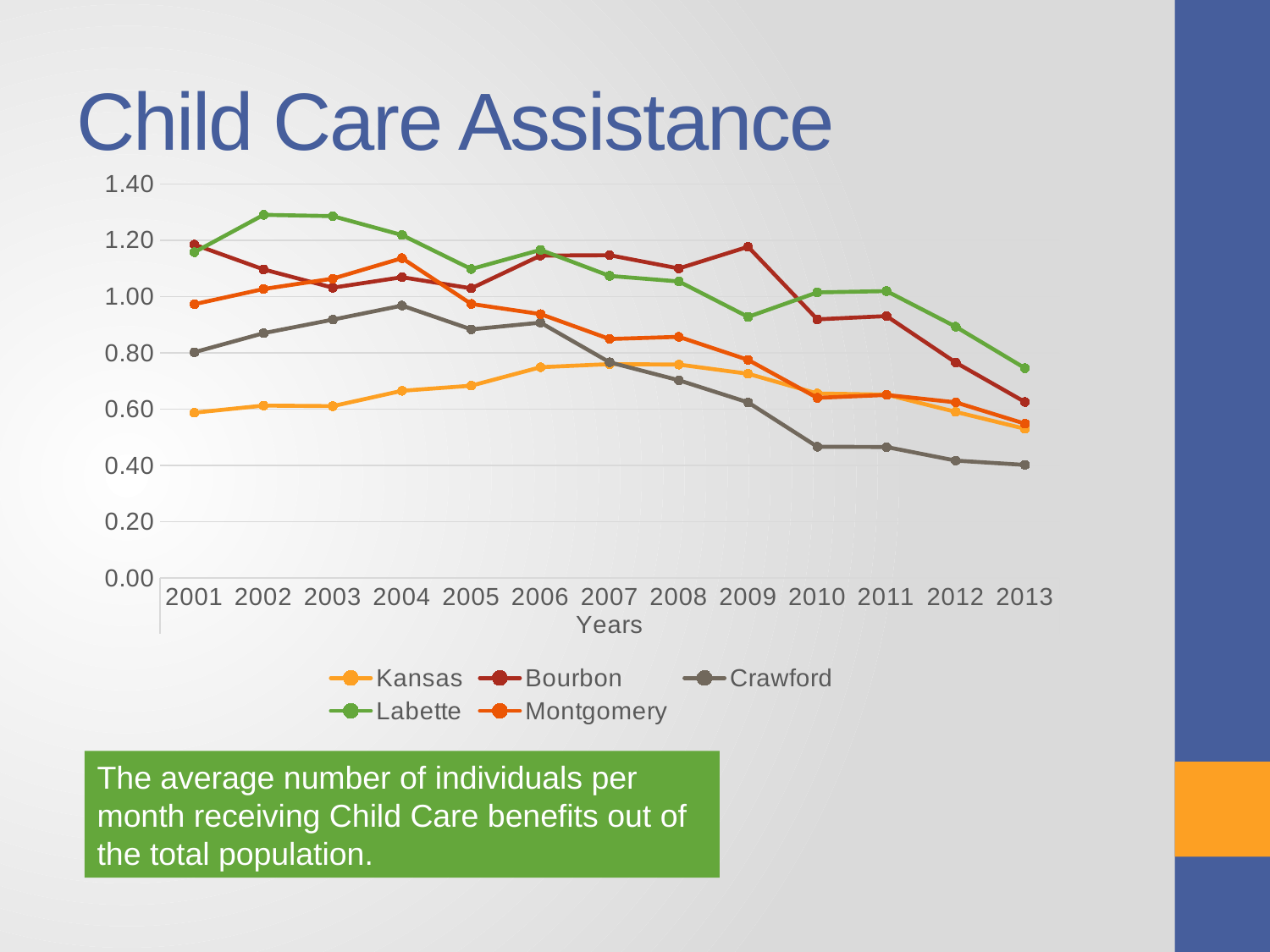
Which series has the lowest value in 2013? Crawford How many years are shown on the x axis? 13 Is the value for Crawford in 2013 greater or less than 0.60? less How many series does the legend list? 5 In 2001, which is larger: the value for Kansas or the value for Crawford? Crawford Is the value for Bourbon in 2009 greater or less than 1.00? greater What is the title of the x axis? Years What kind of chart is shown on the slide? line chart Does the Crawford line rise or fall from 2004 to 2013? fall Which series has the lowest value in 2001? Kansas Which series has the highest value in 2002? Labette Is the value for Labette in 2002 greater or less than 1.20? greater